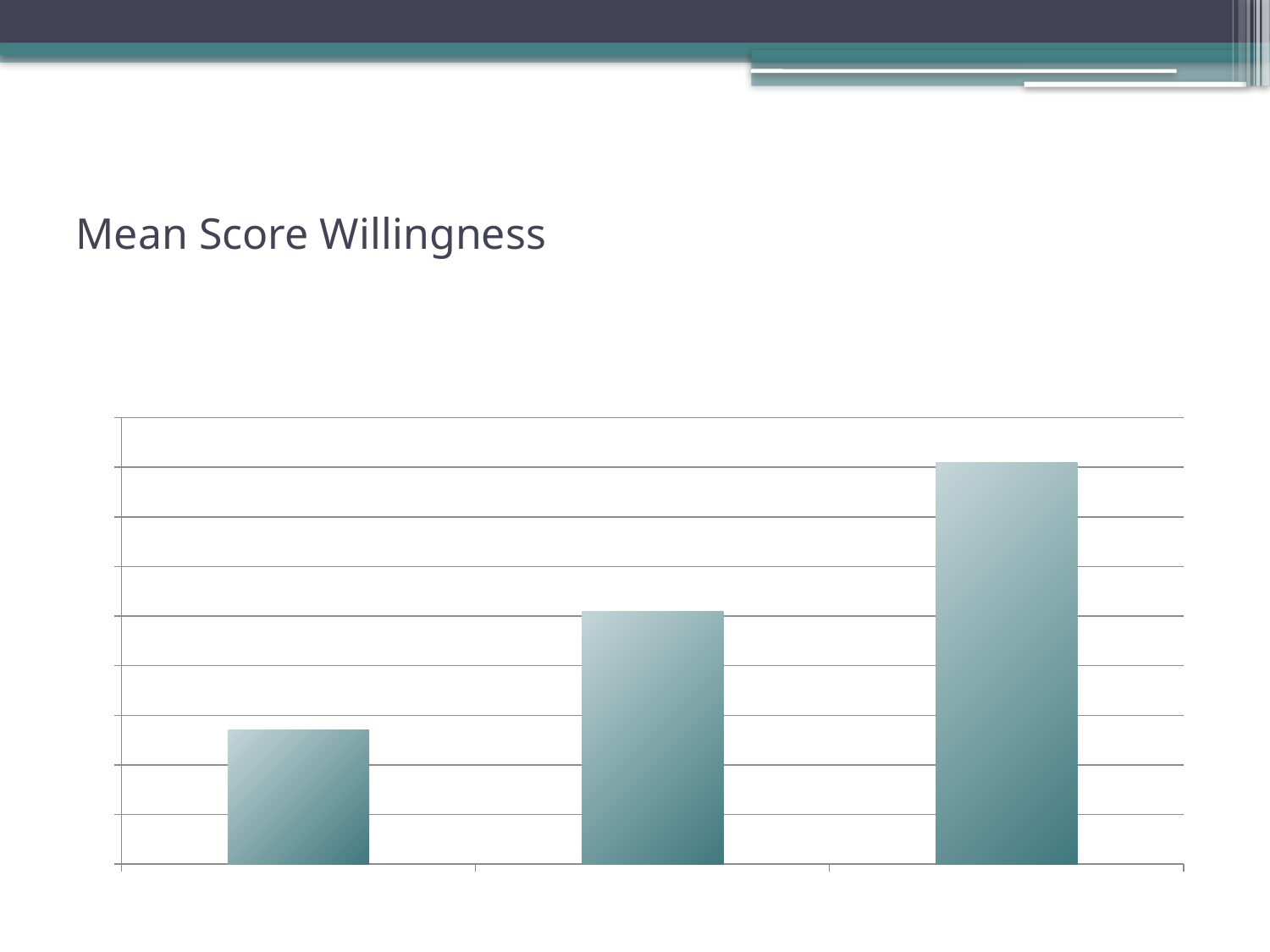
What is the title shown above the chart on the slide? Mean Score Willingness What kind of chart is shown on the slide? bar chart Do the bar values rise or fall from left to right across the chart? rise How many bars are plotted in the chart? 3 Which bar is the tallest in the chart: the left, middle, or right bar? right Which bar is the shortest in the chart: the left, middle, or right bar? left Does the chart display a legend? No Which is larger, the middle bar or the right bar? right bar Which is larger, the middle bar or the left bar? middle bar